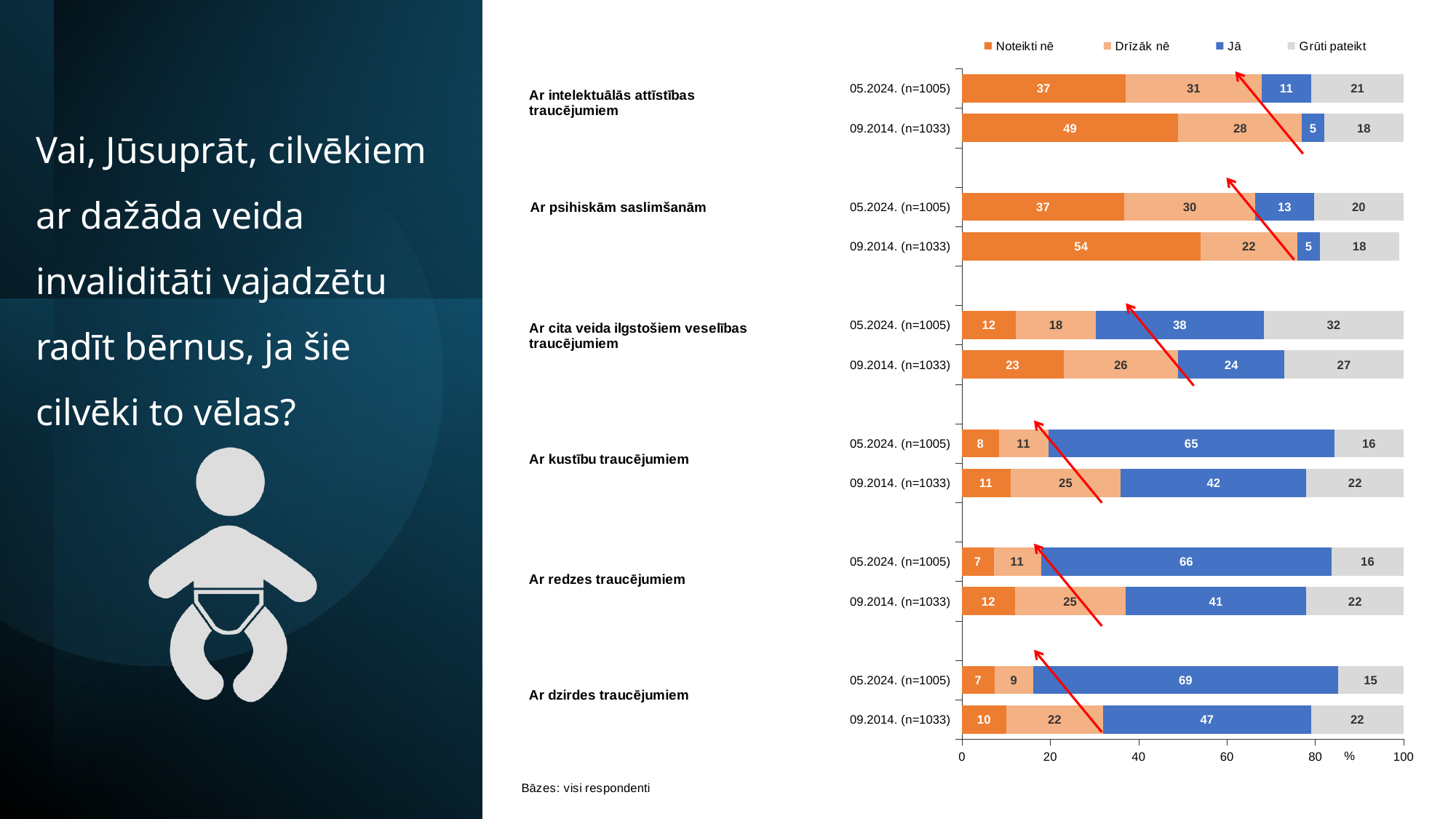
How many series does the legend list? 4 How many bars are plotted in the chart? 12 By how much did the "Jā" value for "Ar kustību traucējumiem" change between 09.2014 and 05.2024? 23 What is the total of the stacked bar for "Ar cita veida ilgstošiem veselības traucējumiem" in 05.2024 (n=1005)? 100 Which category has the highest "Jā" value in the 05.2024 bars? Ar dzirdes traucējumiem What is the value of the "Grūti pateikt" segment for "Ar cita veida ilgstošiem veselības traucējumiem" in 09.2014 (n=1033)? 27 For "Ar intelektuālās attīstības traucējumiem", is the "Noteikti nē" value larger in 05.2024 or in 09.2014? 09.2014 What kind of chart is shown on the slide? Stacked bar chart What is the value of the "Jā" segment for "Ar dzirdes traucējumiem" in 05.2024 (n=1005)? 69 Which category has the lowest "Grūti pateikt" value in the 05.2024 bars? Ar dzirdes traucējumiem What is the value of the "Noteikti nē" segment for "Ar psihiskām saslimšanām" in 09.2014 (n=1033)? 54 Did the "Jā" value for "Ar redzes traucējumiem" rise or fall from 09.2014 to 05.2024? Rise